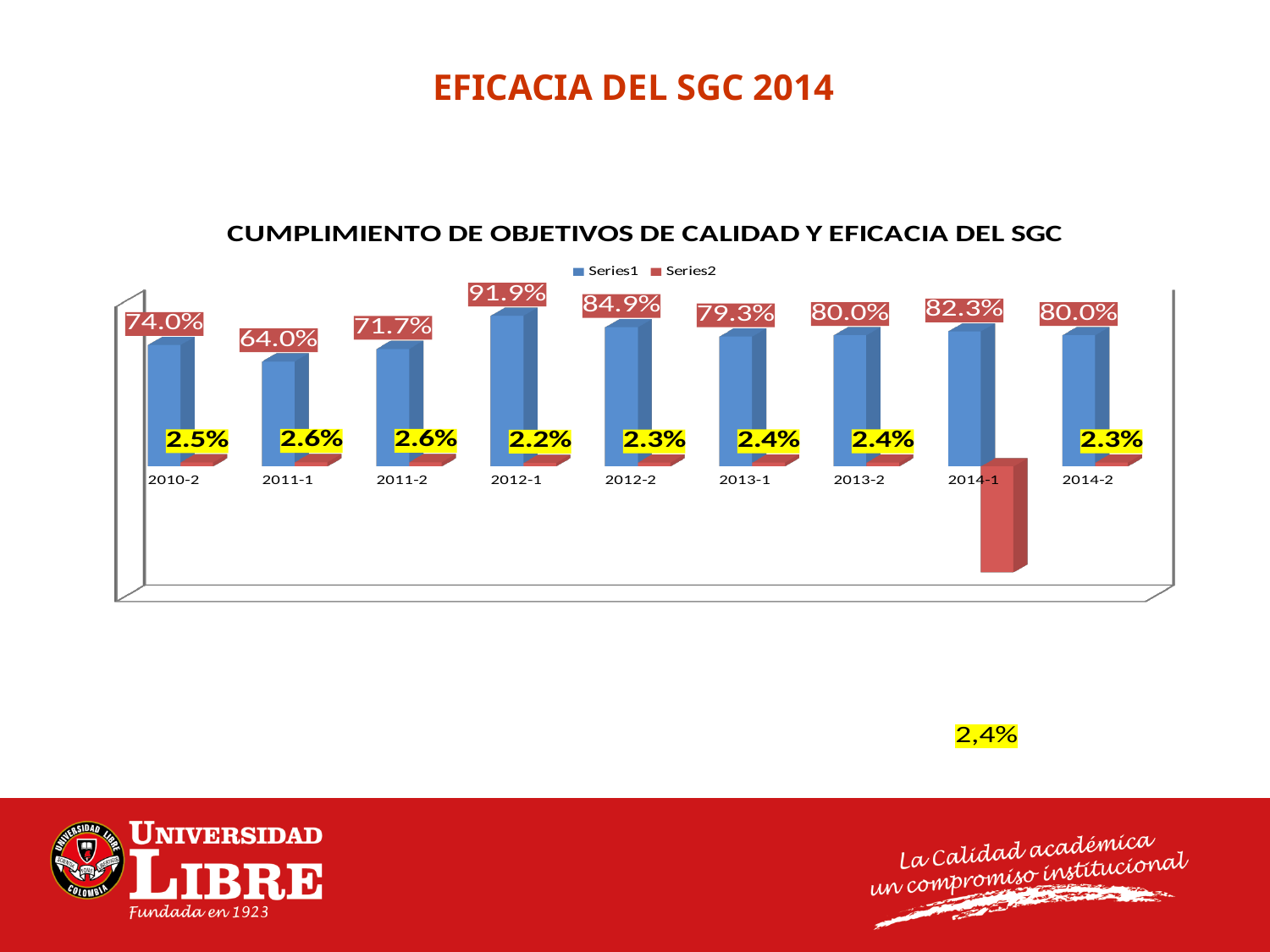
How many series does the legend list? 2 Which category has the highest Series1 value? 2012-1 What is the title of the chart? CUMPLIMIENTO DE OBJETIVOS DE CALIDAD Y EFICACIA DEL SGC How many categories are shown on the x axis? 9 What is the Series1 value for 2012-1? 91.9% What is the Series1 value for 2011-1? 64.0% Which has the larger Series1 value, 2012-2 or 2013-1? 2012-2 What is the difference between the Series1 values for 2012-1 and 2011-1? 27.9 percentage points Which category has the lowest Series1 value? 2011-1 Do the Series1 values rise or fall from 2011-1 to 2012-1? Rise What kind of chart is shown on the slide? Bar chart What is the Series2 value for 2010-2? 2.5%